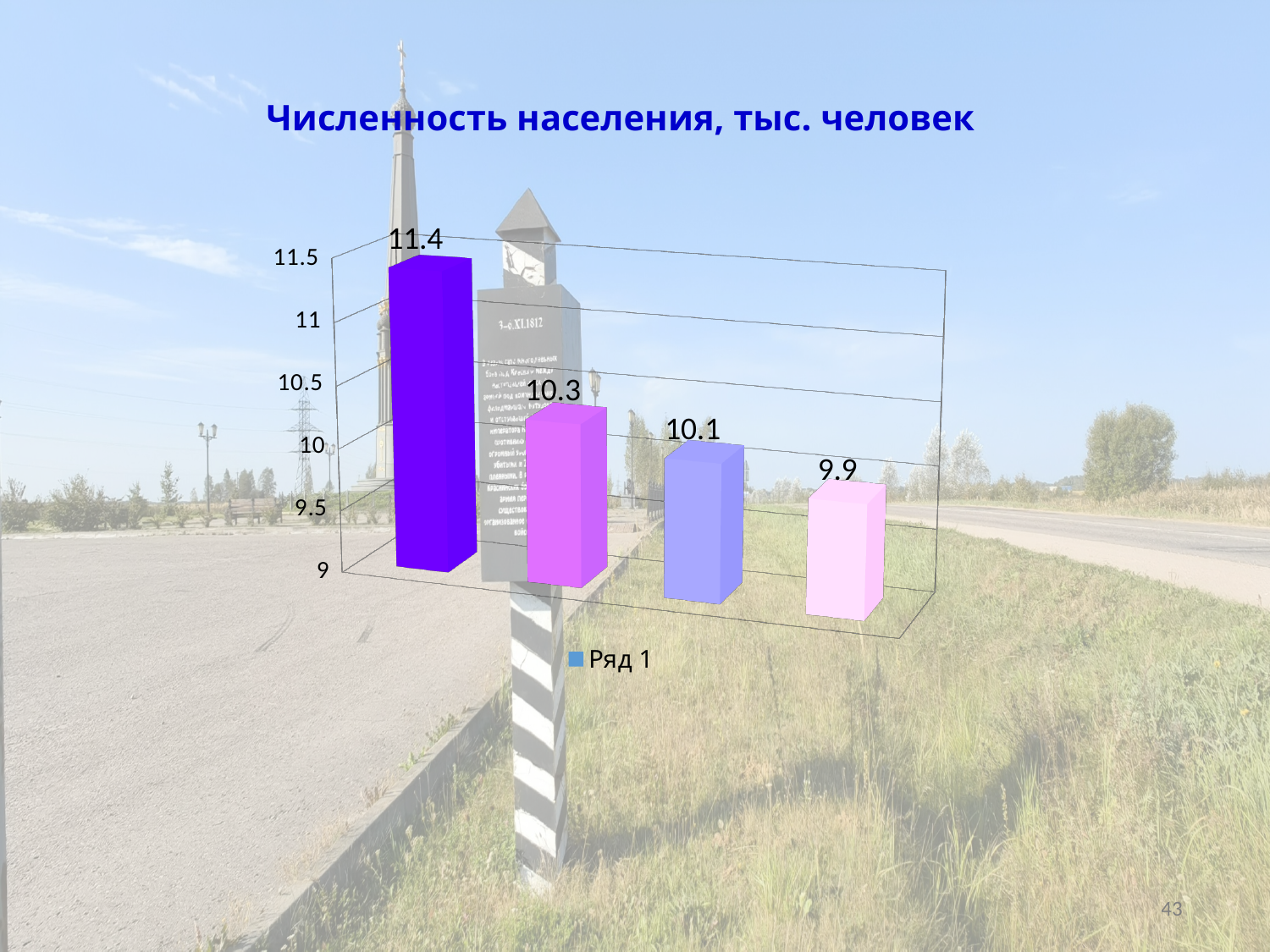
How many series does the legend list? 1 Do the values rise or fall from left to right across the chart? fall What is the value shown on the second bar from the left? 10.3 What is the lowest value plotted in the chart? 9.9 What kind of chart is shown on the slide? bar chart What is the title of the chart? Численность населения, тыс. человек What is the value shown on the last (rightmost) bar? 9.9 What is the value shown on the third bar from the left? 10.1 How many bars are plotted in the chart? 4 What is the highest value plotted in the chart? 11.4 What is the value shown on the first (leftmost) bar? 11.4 What is the difference between the first bar (11.4) and the last bar (9.9)? 1.5